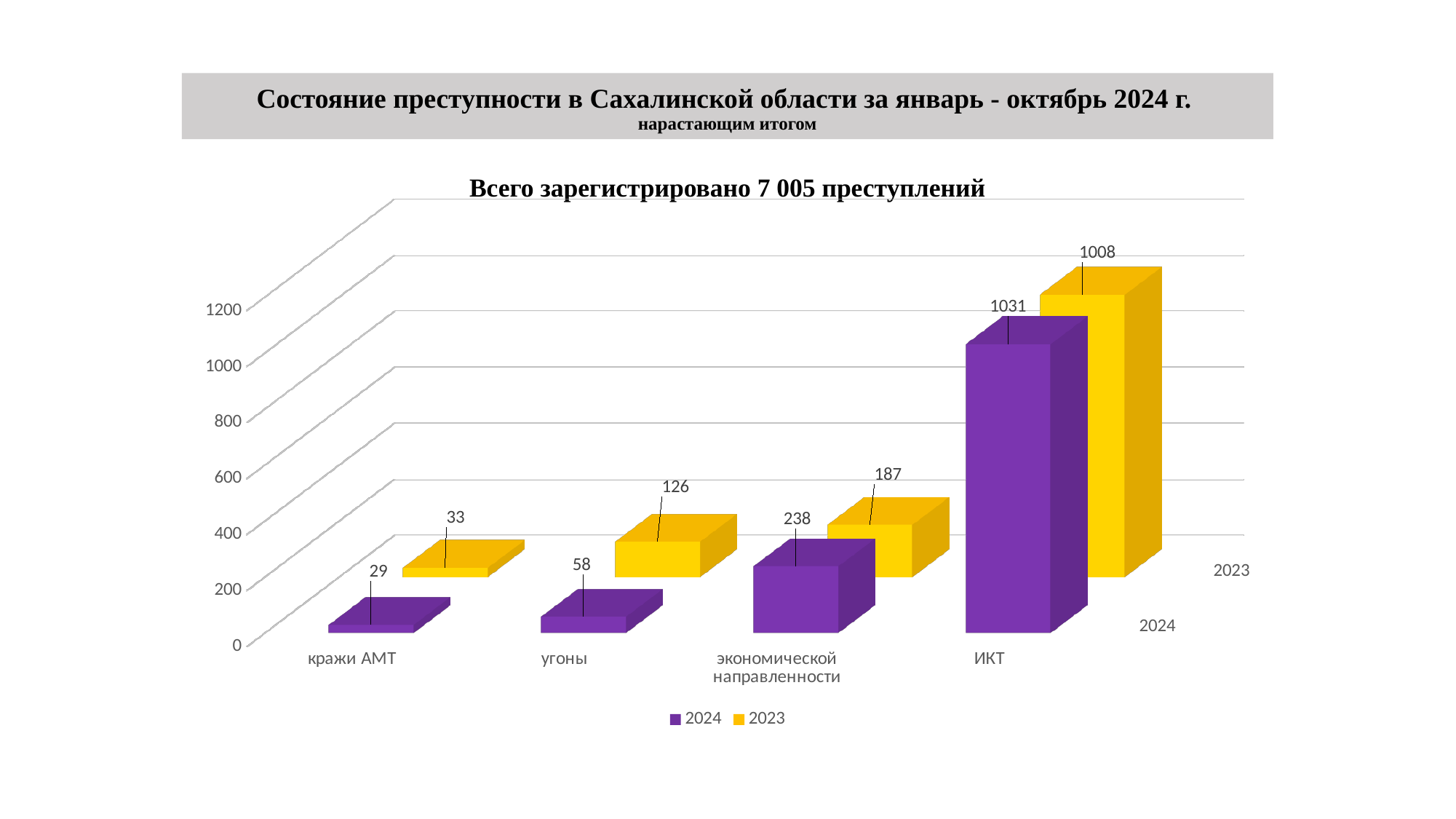
Which category has the highest 2024 value? ИКТ What is the chart's title? Всего зарегистрировано 7 005 преступлений How many categories are shown on the x axis? 4 What kind of chart is shown? bar chart What is the 2023 value for угоны? 126 Which is larger for экономической направленности: the 2024 value or the 2023 value? 2024 What is the 2024 value for экономической направленности? 238 How many series does the legend list? 2 What is the 2024 value for ИКТ? 1031 What is the 2023 value for кражи АМТ? 33 What is the difference between the 2024 and 2023 values for угоны? 68 Which category has the lowest 2023 value? кражи АМТ